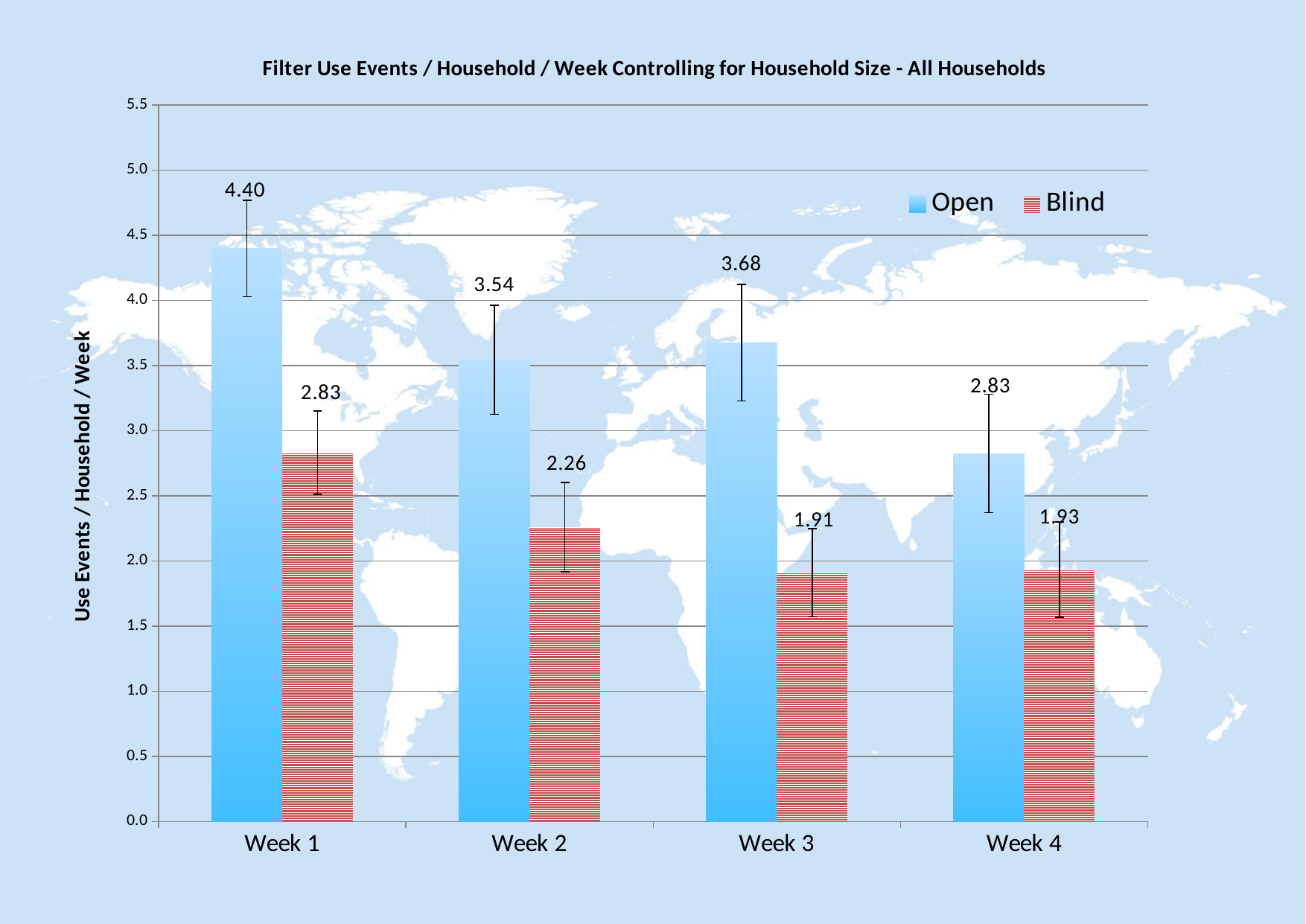
Which is larger, the Open value in Week 2 or the Open value in Week 3? Open value in Week 3 Is the Blind value for Week 1 greater or less than 2.5? greater How many weeks are shown on the x axis? 4 Which week has the highest Open value? Week 1 What is the value for Blind in Week 3? 1.91 What kind of chart is shown on the slide? Bar chart What is the value for Open in Week 1? 4.40 What is the value for Open in Week 4? 2.83 What is the difference between the Open and Blind values in Week 2? 1.28 What is the label on the vertical axis? Use Events / Household / Week How many series does the legend list? 2 Which week has the lowest Blind value? Week 3